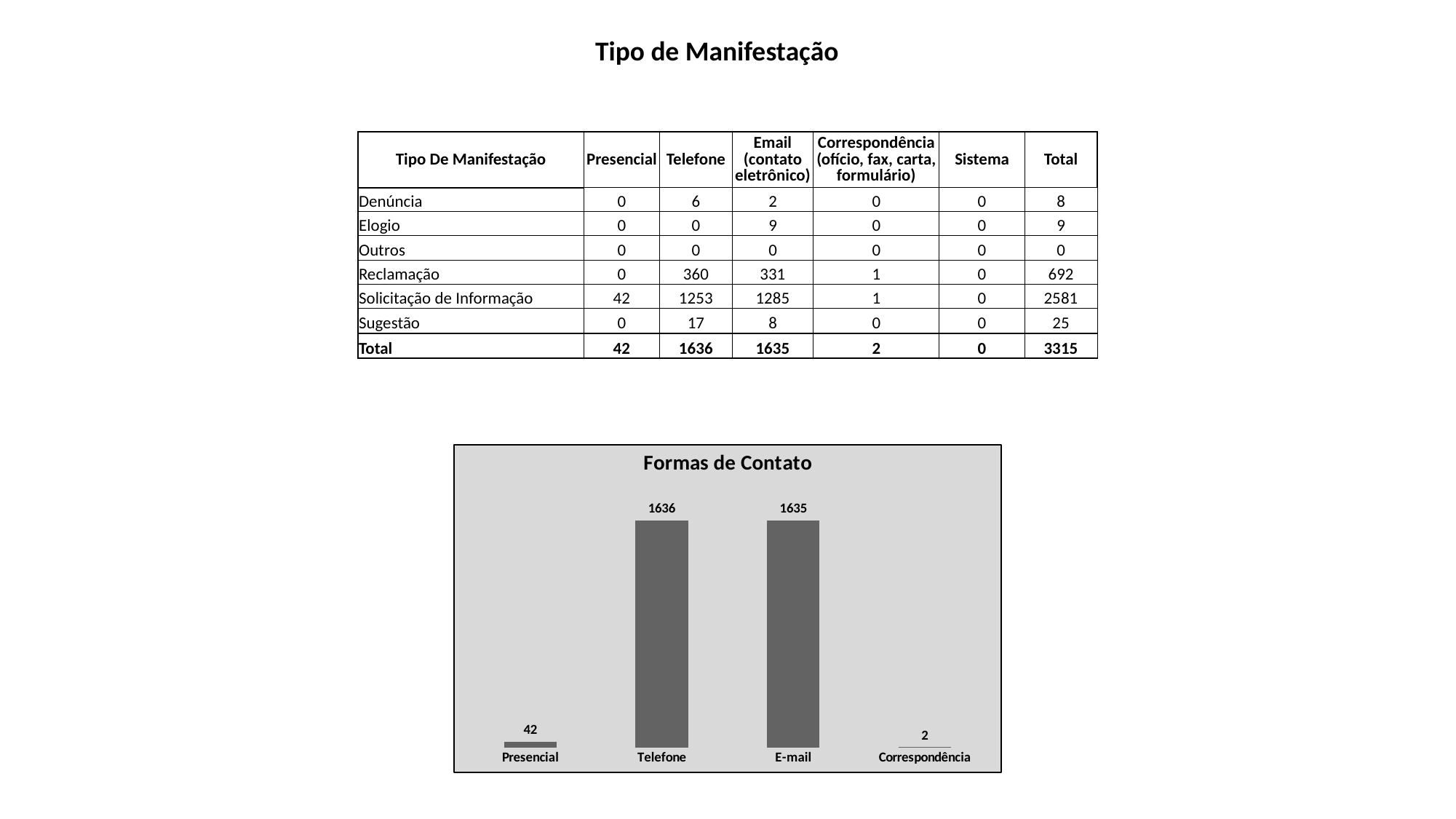
According to the data labels, which category has the highest value in the Formas de Contato chart? Telefone What is the difference between the Presencial and Correspondência values in the Formas de Contato chart? 40 How many categories are shown in the Formas de Contato chart? 4 What is the value for Presencial in the Formas de Contato chart? 42 What type of chart is Formas de Contato? Bar chart What is the value for Correspondência in the Formas de Contato chart? 2 What is the value for E-mail in the Formas de Contato chart? 1635 In the Formas de Contato chart, which is larger: Presencial or Correspondência? Presencial What is the value for Telefone in the Formas de Contato chart? 1636 Which category has the lowest value in the Formas de Contato chart? Correspondência What is the difference between the Telefone and E-mail values in the Formas de Contato chart? 1 What is the title of the chart on the slide? Formas de Contato